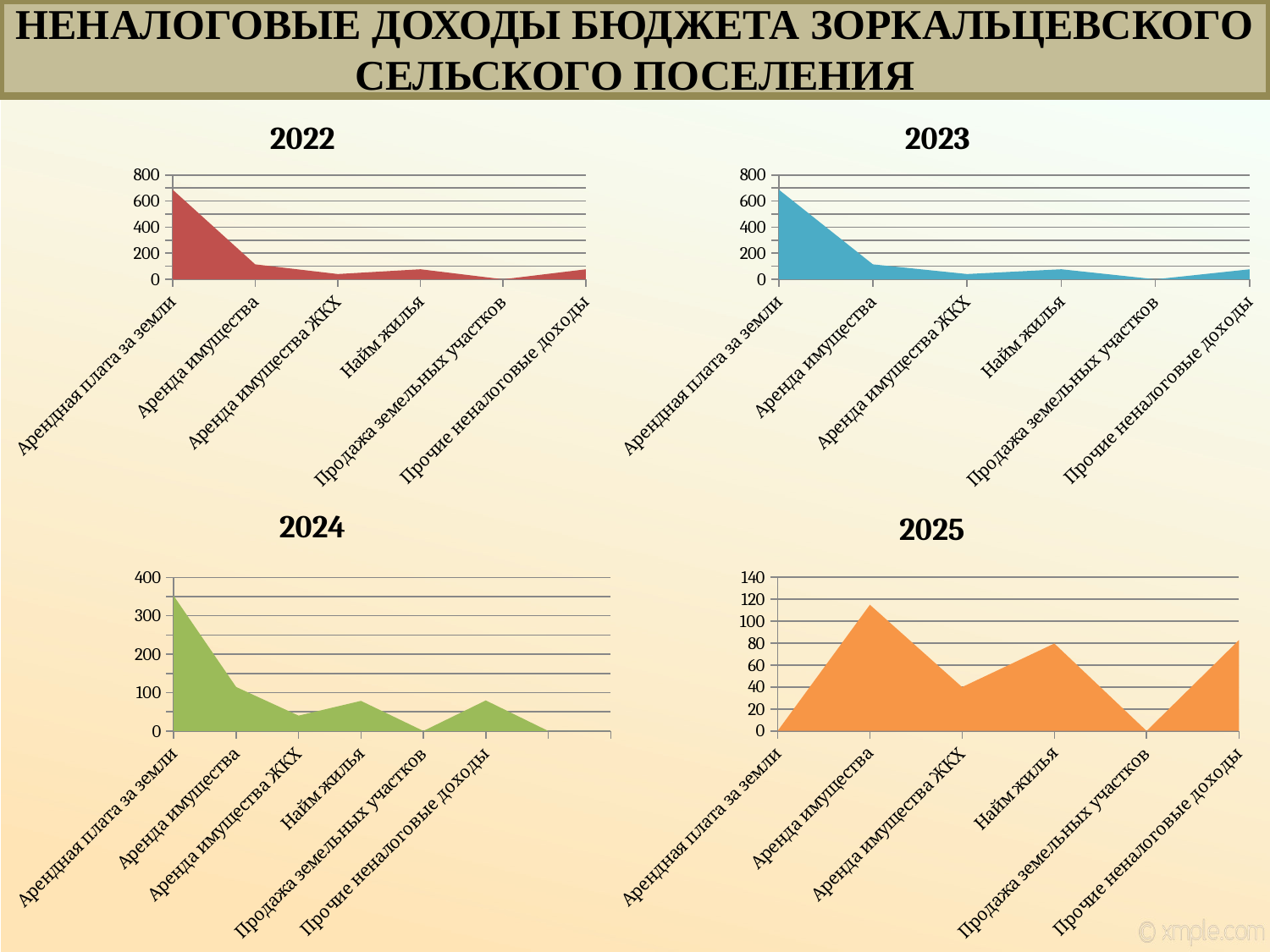
In the 2025 chart, is the value for Аренда имущества greater or less than 100? greater What kind of chart is the 2022 chart? area chart In the 2022 chart, which category has the highest value? Арендная плата за земли How many categories are labelled on the x axis of the 2023 chart? 6 How many charts are shown on the slide? 4 In the 2024 chart, which is larger: Аренда имущества or Аренда имущества ЖКХ? Аренда имущества In the 2024 chart, is the value for Арендная плата за земли greater or less than 300? greater In the 2023 chart, is the value for Аренда имущества greater or less than 200? less In the 2022 chart, which category has the lowest value? Продажа земельных участков In the 2025 chart, which category has the highest value? Аренда имущества What is the title of the top-left chart? 2022